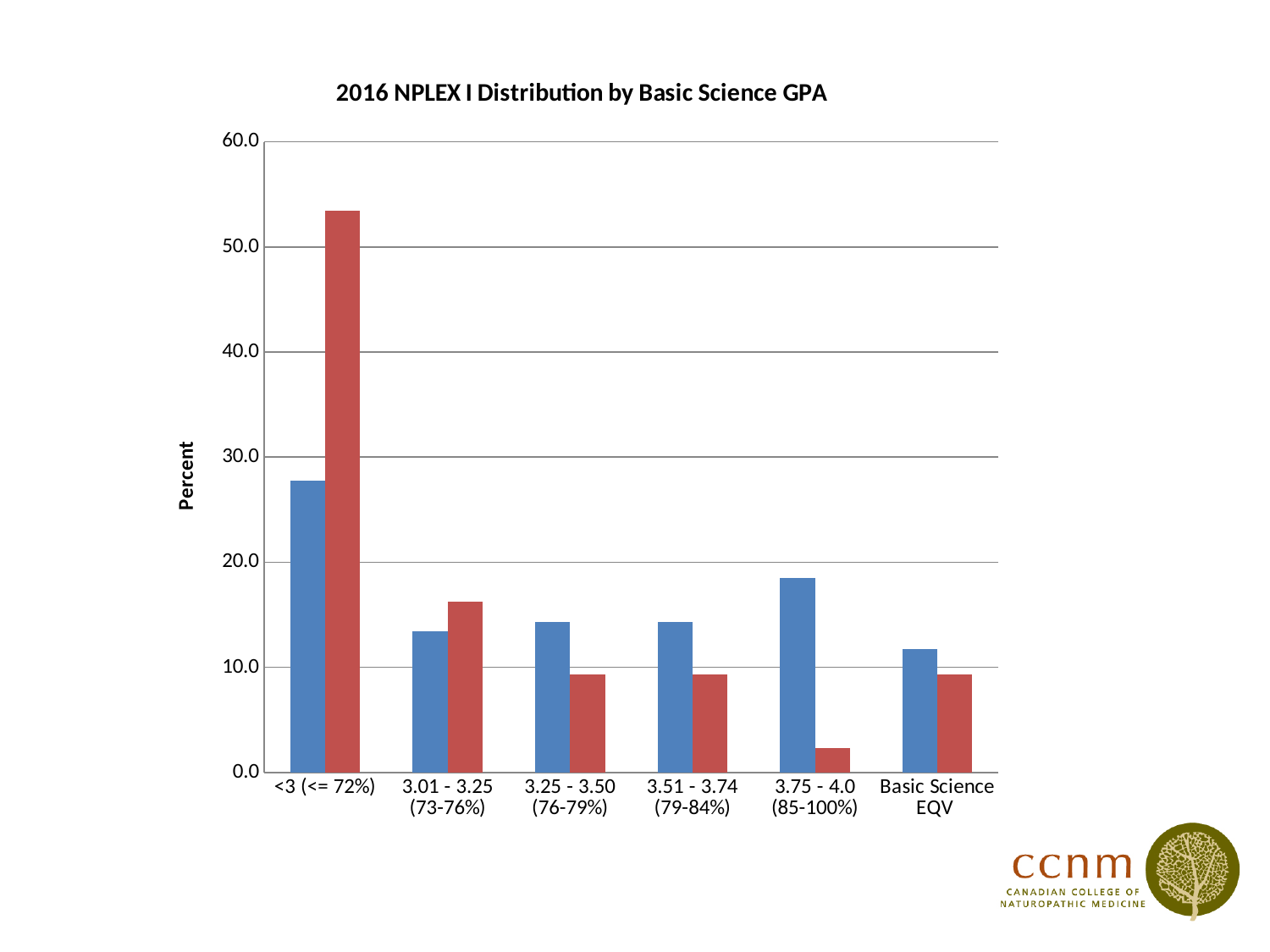
For the 3.75 - 4.0 (85-100%) category, which bar is taller, the blue or the red? Blue Which category has the tallest blue bar? <3 (<= 72%) Which category has the shortest red bar? 3.75 - 4.0 (85-100%) Which category has the tallest red bar? <3 (<= 72%) Is the red bar for <3 (<= 72%) greater or less than 50? greater What is the title of the chart? 2016 NPLEX I Distribution by Basic Science GPA How many data series (bar colours) are plotted for each category? 2 How many GPA categories are shown along the x axis? 6 What type of chart is shown on the slide? Bar chart Is the blue bar for <3 (<= 72%) greater or less than 30? less What is the label on the vertical axis of the chart? Percent Is the red bar for 3.75 - 4.0 (85-100%) greater or less than 10? less